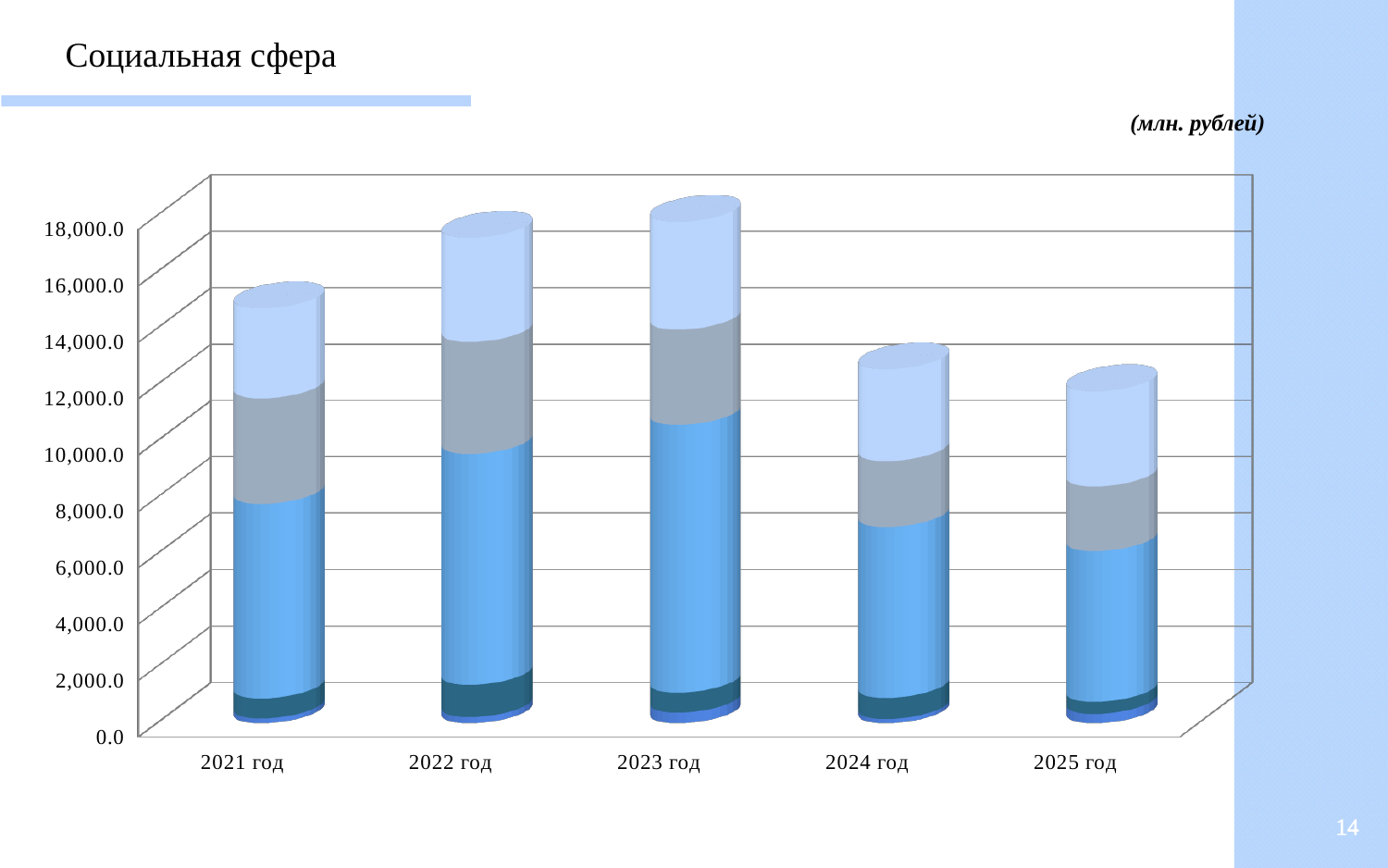
What is the title of the slide containing the chart? Социальная сфера Is the total for 2025 год greater or less than 14,000.0? less Do the bar totals rise or fall from 2023 год to 2025 год? fall Is the total for 2024 год greater or less than 14,000.0? less Which bar is taller, 2022 год or 2024 год? 2022 год What kind of chart is shown on the slide? Stacked bar chart Which year has the tallest bar (highest total) in the chart? 2023 год Which year has the shortest bar (lowest total) in the chart? 2025 год In what units are the chart values expressed, according to the slide? млн. рублей Is the total for 2022 год greater or less than 16,000.0? greater How many years (categories) are shown on the x axis of the chart? 5